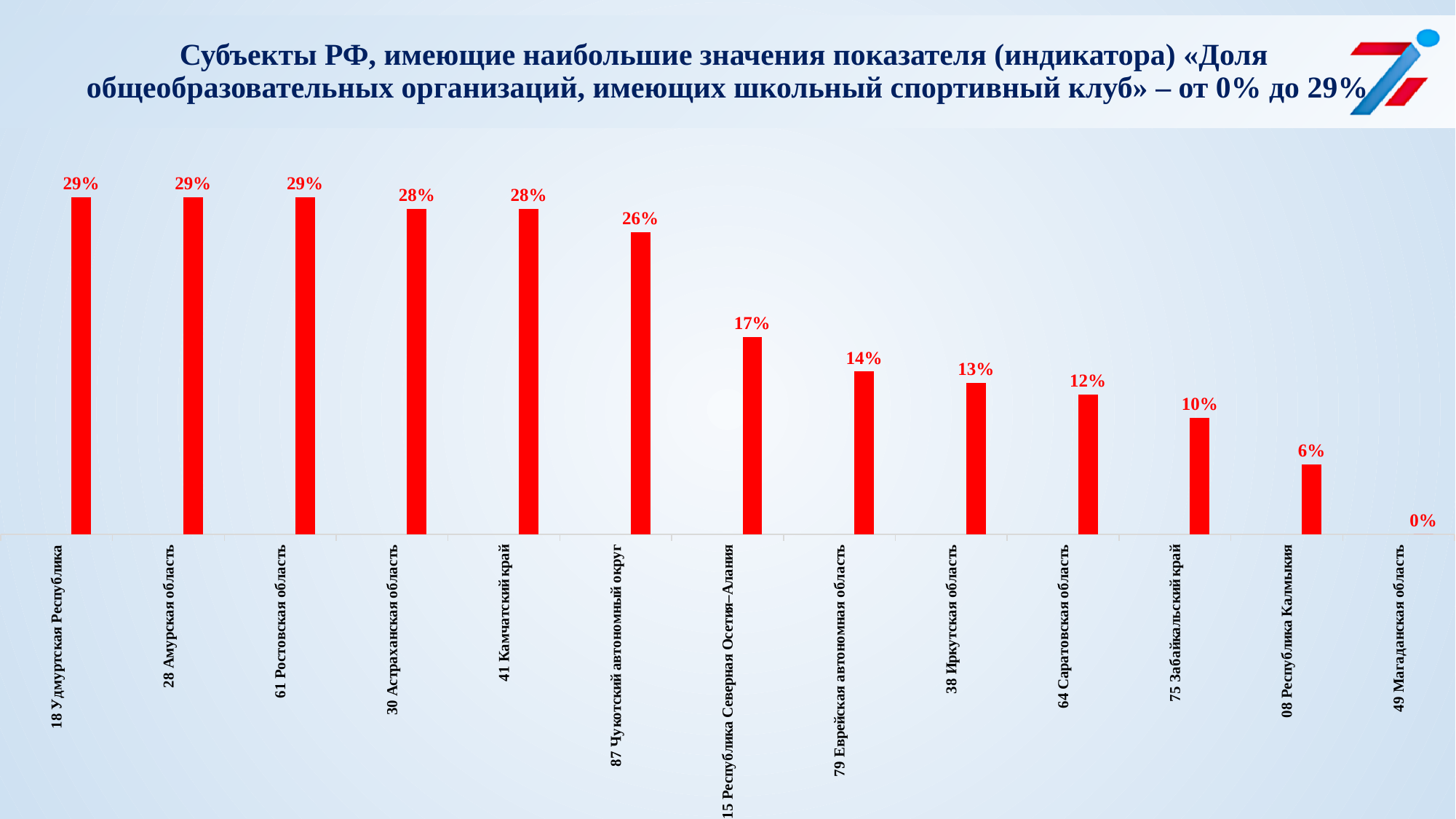
Which is larger, the value for 41 Камчатский край or the value for 87 Чукотский автономный округ? 41 Камчатский край What is the value for 15 Республика Северная Осетия–Алания? 17% Do the values rise or fall from left to right along the x axis? fall What is the value for 08 Республика Калмыкия? 6% What is the value for 87 Чукотский автономный округ? 26% What colour are the bars on the chart? red What is the value for 64 Саратовская область? 12% Which category has the lowest value? 49 Магаданская область How many categories are shown on the chart? 13 What is the difference between the values for 30 Астраханская область and 79 Еврейская автономная область? 14% What kind of chart is shown on the slide? bar chart What is the difference between the values for 38 Иркутская область and 75 Забайкальский край? 3%